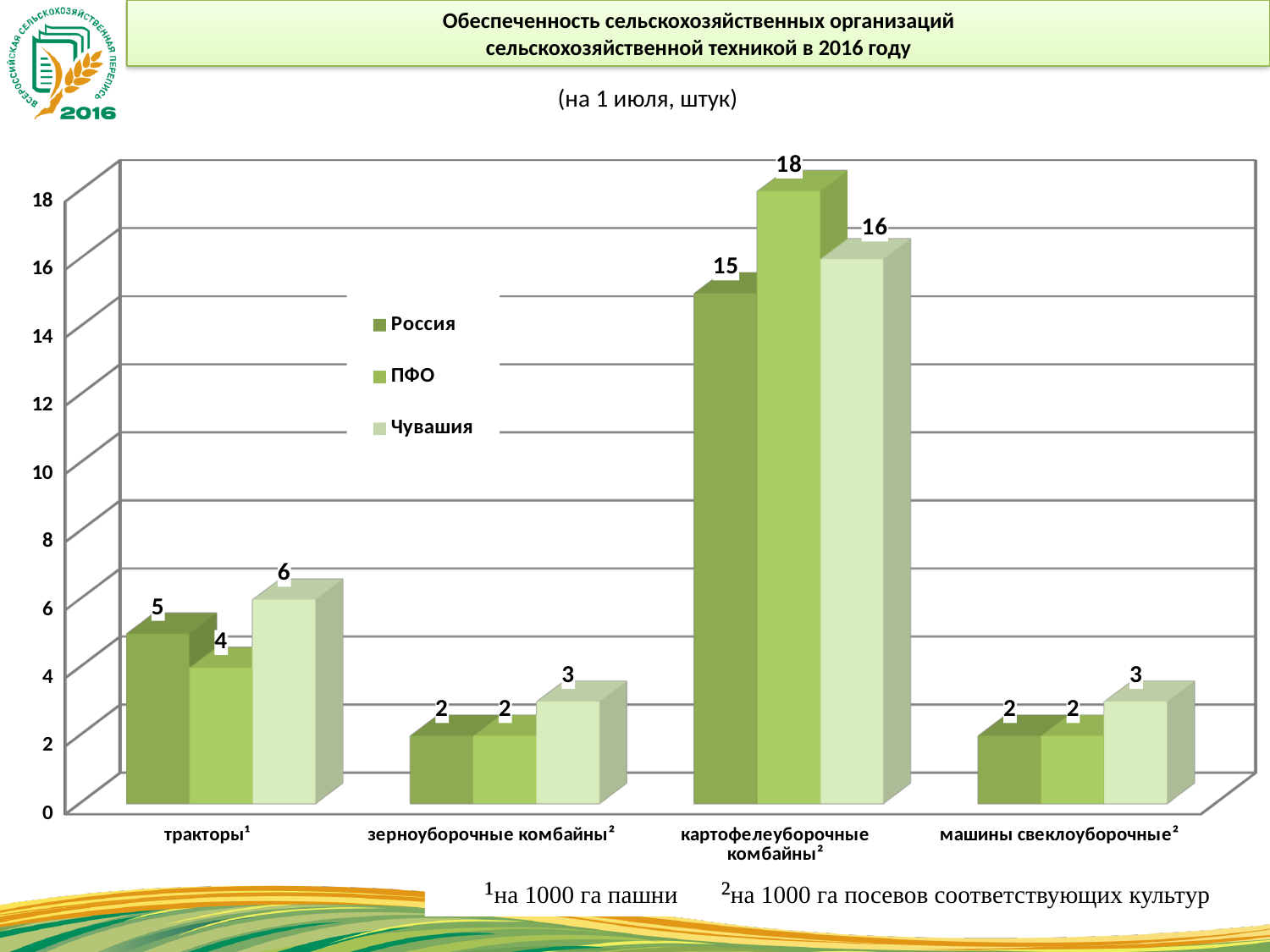
Which category has the highest value for ПФО? картофелеуборочные комбайны What is the difference between the ПФО and Россия values for картофелеуборочные комбайны? 3 What is the value for Чувашия in the картофелеуборочные комбайны category? 16 Which series has the lowest value in the тракторы category? ПФО How many categories are shown on the x axis? 4 What is the value for ПФО in the зерноуборочные комбайны category? 2 What kind of chart is shown on the slide? bar chart Is the value for ПФО in the картофелеуборочные комбайны category greater or less than 16? greater What is the value for Чувашия in the машины свеклоуборочные category? 3 Which is larger in the тракторы category: the value for Чувашия or the value for Россия? Чувашия How many series does the legend list? 3 What is the value for Россия in the тракторы category? 5